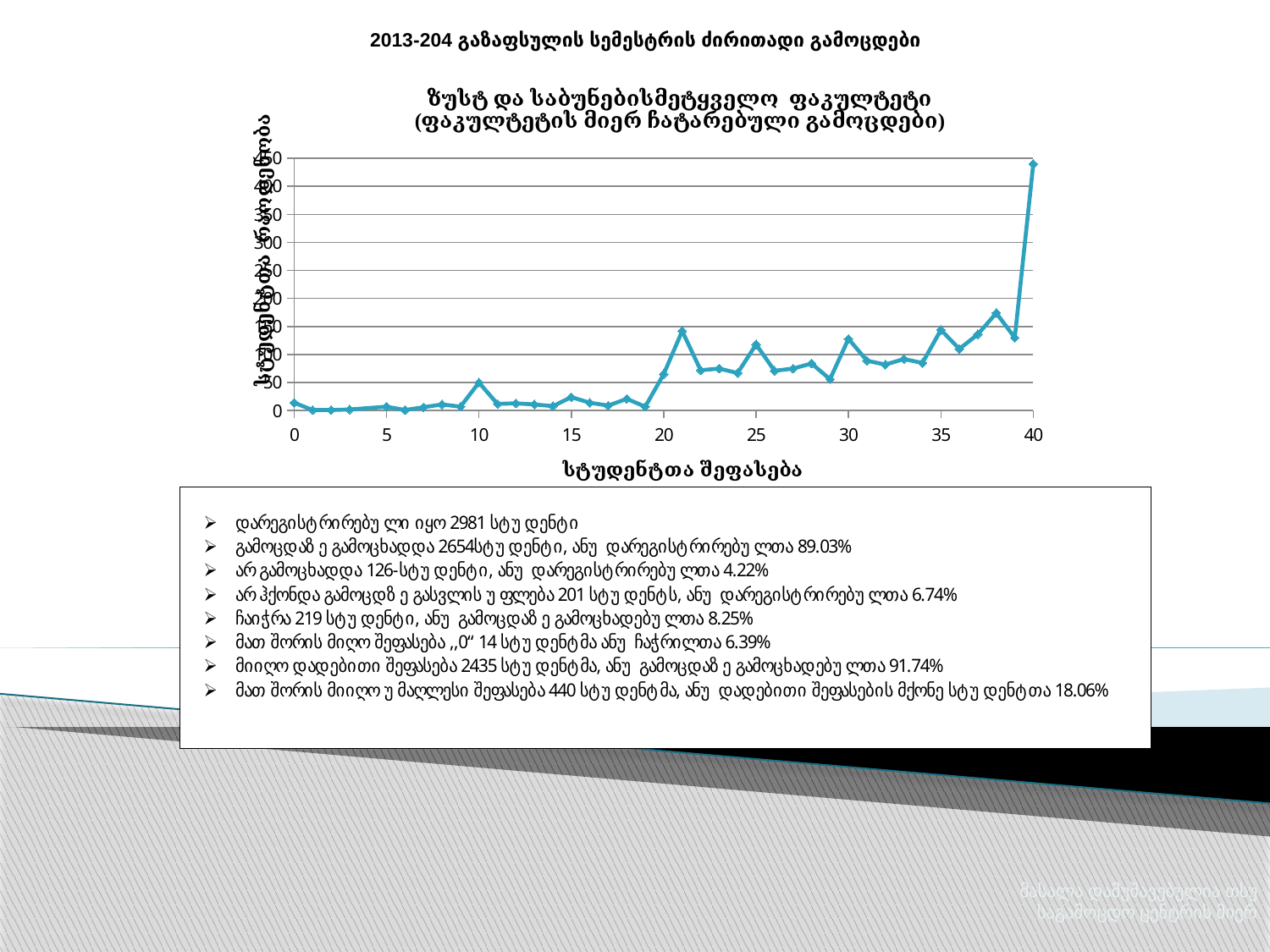
What is the title of the x axis of the chart? სტუდენტთა შეფასება Which has more students: score 21 or score 10? score 21 Overall, do the values rise or fall as the student score increases along the x axis? rise What kind of chart is shown on the slide? line chart Which has more students: score 40 or score 20? score 40 How many labelled tick marks are shown on the x axis? 9 Is the number of students at score 0 greater or less than 50? less Is the number of students at score 20 greater or less than 100? less Is the number of students at score 15 greater or less than 50? less At which student score (x-axis value) does the line reach its highest number of students? 40